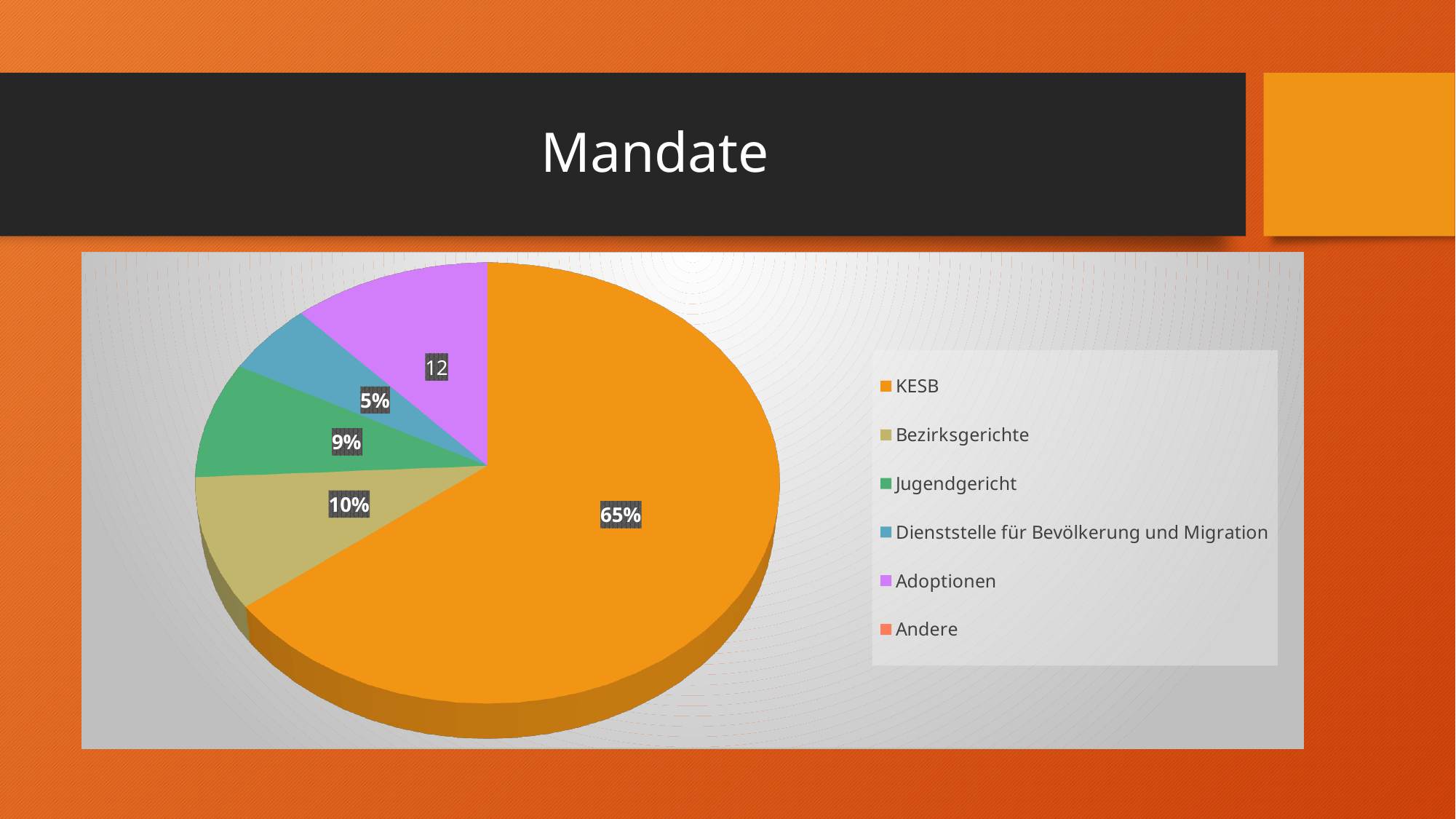
Which of the labelled slices is the smallest? Dienststelle für Bevölkerung und Migration What is the value shown for Dienststelle für Bevölkerung und Migration? 5% Which category has the largest slice of the pie? KESB What label is printed on the Adoptionen slice? 12 How many categories does the legend list? 6 What is the value shown for Bezirksgerichte? 10% What is the value shown for KESB? 65% What colour is the KESB slice? orange What is the value shown for Jugendgericht? 9% Which is larger, the slice for Bezirksgerichte or the slice for Jugendgericht? Bezirksgerichte What kind of chart is shown on the slide? pie chart What is the difference between the KESB value and the Bezirksgerichte value? 55%